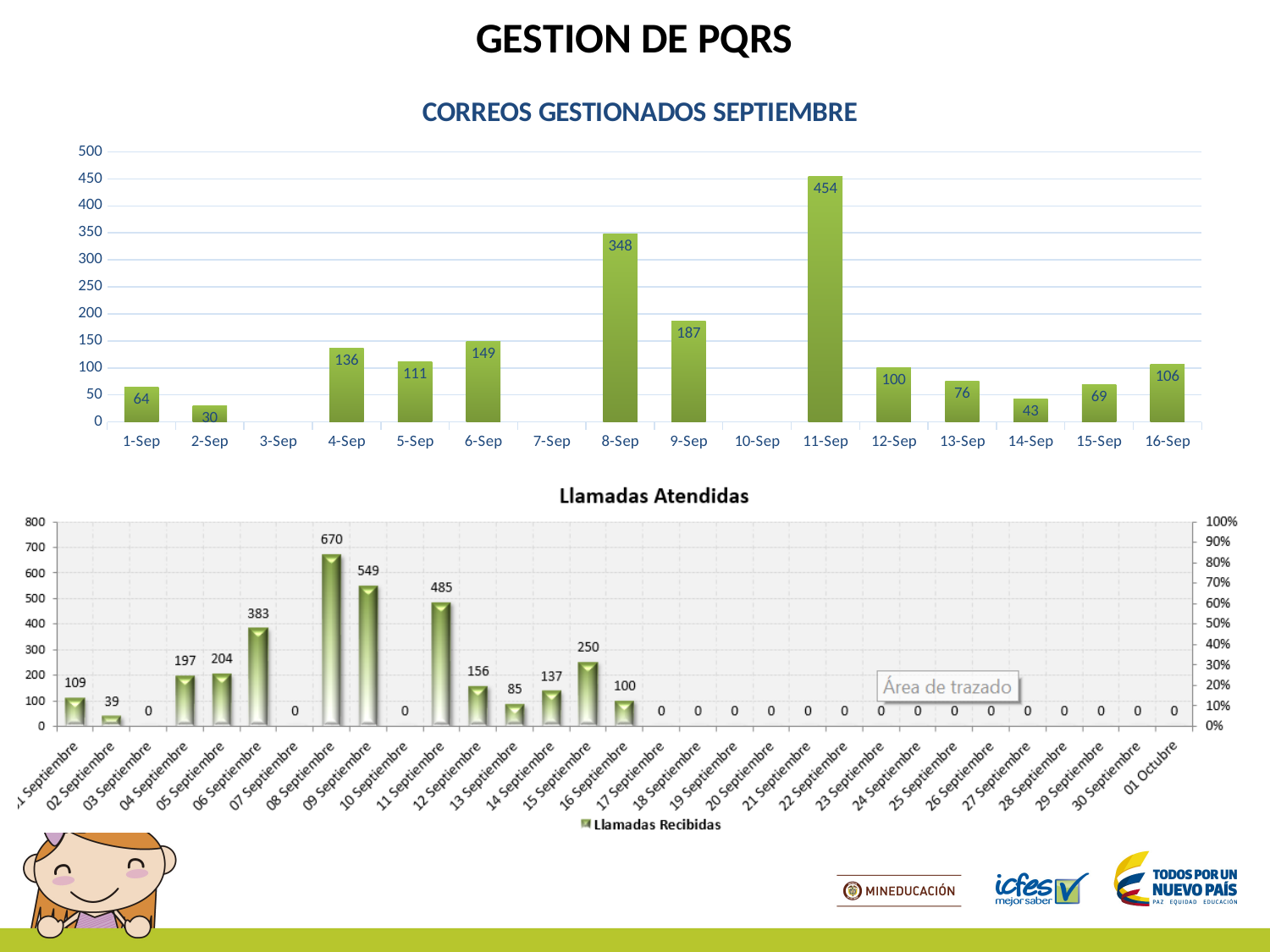
In the Llamadas Atendidas chart, what is the value for 08 Septiembre? 670 In the CORREOS GESTIONADOS SEPTIEMBRE chart, which is larger, the value for 4-Sep or the value for 5-Sep? 4-Sep In the CORREOS GESTIONADOS SEPTIEMBRE chart, which date has the highest value? 11-Sep In the CORREOS GESTIONADOS SEPTIEMBRE chart, what is the difference between the values for 8-Sep and 9-Sep? 161 In the Llamadas Atendidas chart, what is the value for 15 Septiembre? 250 What series name does the legend of the Llamadas Atendidas chart show? Llamadas Recibidas In the Llamadas Atendidas chart, what is the difference between the values for 09 Septiembre and 11 Septiembre? 64 In the CORREOS GESTIONADOS SEPTIEMBRE chart, what is the value for 11-Sep? 454 In the Llamadas Atendidas chart, which is larger, the value for 04 Septiembre or the value for 05 Septiembre? 05 Septiembre What kind of chart is the CORREOS GESTIONADOS SEPTIEMBRE chart? Bar chart In the Llamadas Atendidas chart, which date has the highest value? 08 Septiembre In the CORREOS GESTIONADOS SEPTIEMBRE chart, what is the value for 14-Sep? 43